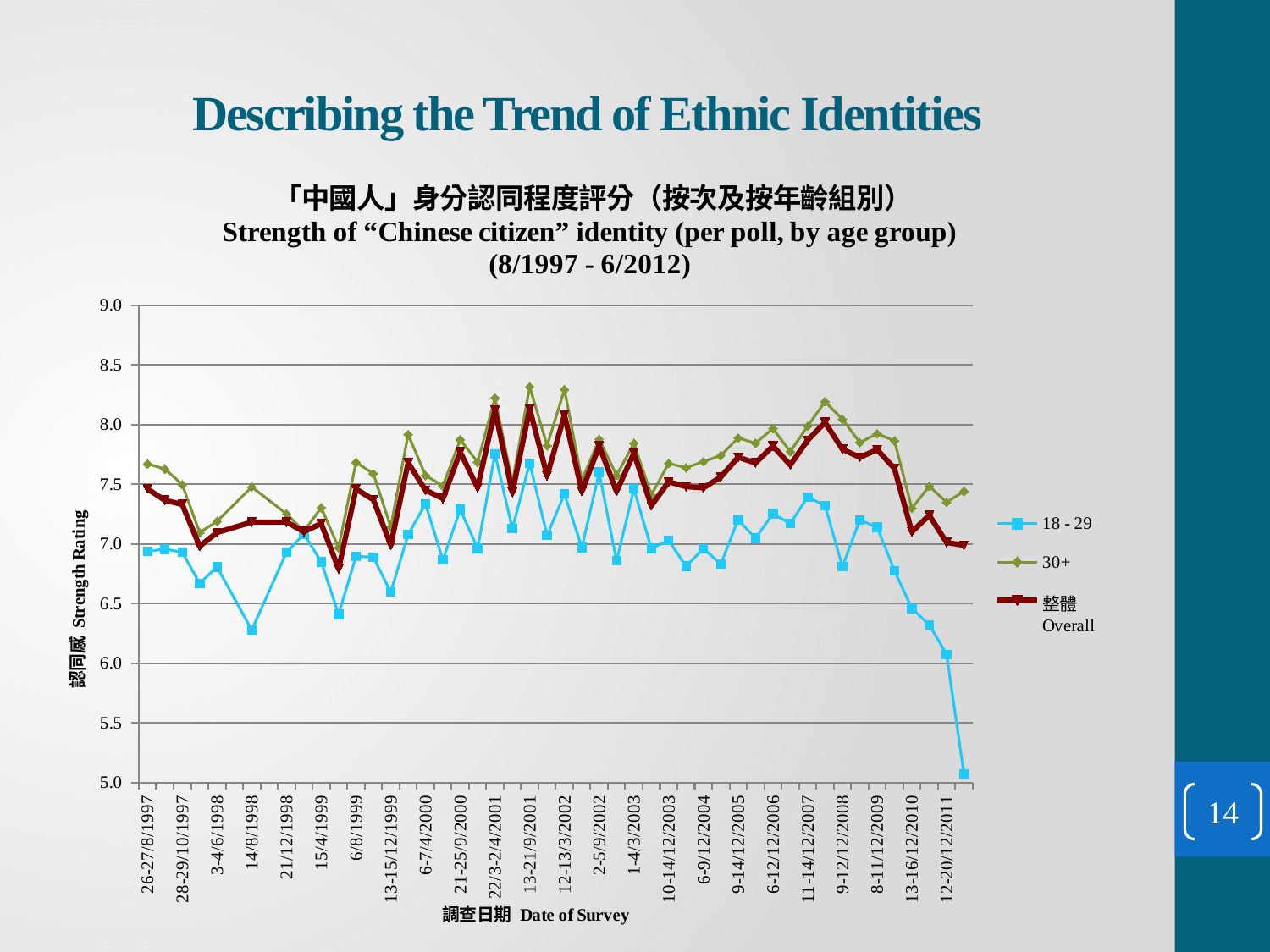
Which series has the lowest values across almost all surveys? 18 - 29 How many series does the legend list? 3 At 13-21/9/2001, is the value for the 30+ series greater or less than 8.0? greater What kind of chart is shown on the slide? line chart What is the label of the vertical axis? Strength Rating At 14/8/1998, is the Overall value greater or less than 7.0? greater At 26-27/8/1997, which series has the larger value, 30+ or 18 - 29? 30+ At 14/8/1998, is the value for the 18 - 29 series greater or less than 6.5? less Which series is plotted with the light blue line? 18 - 29 Does the 18 - 29 series rise or fall from 8-11/12/2009 to the end of the chart? fall